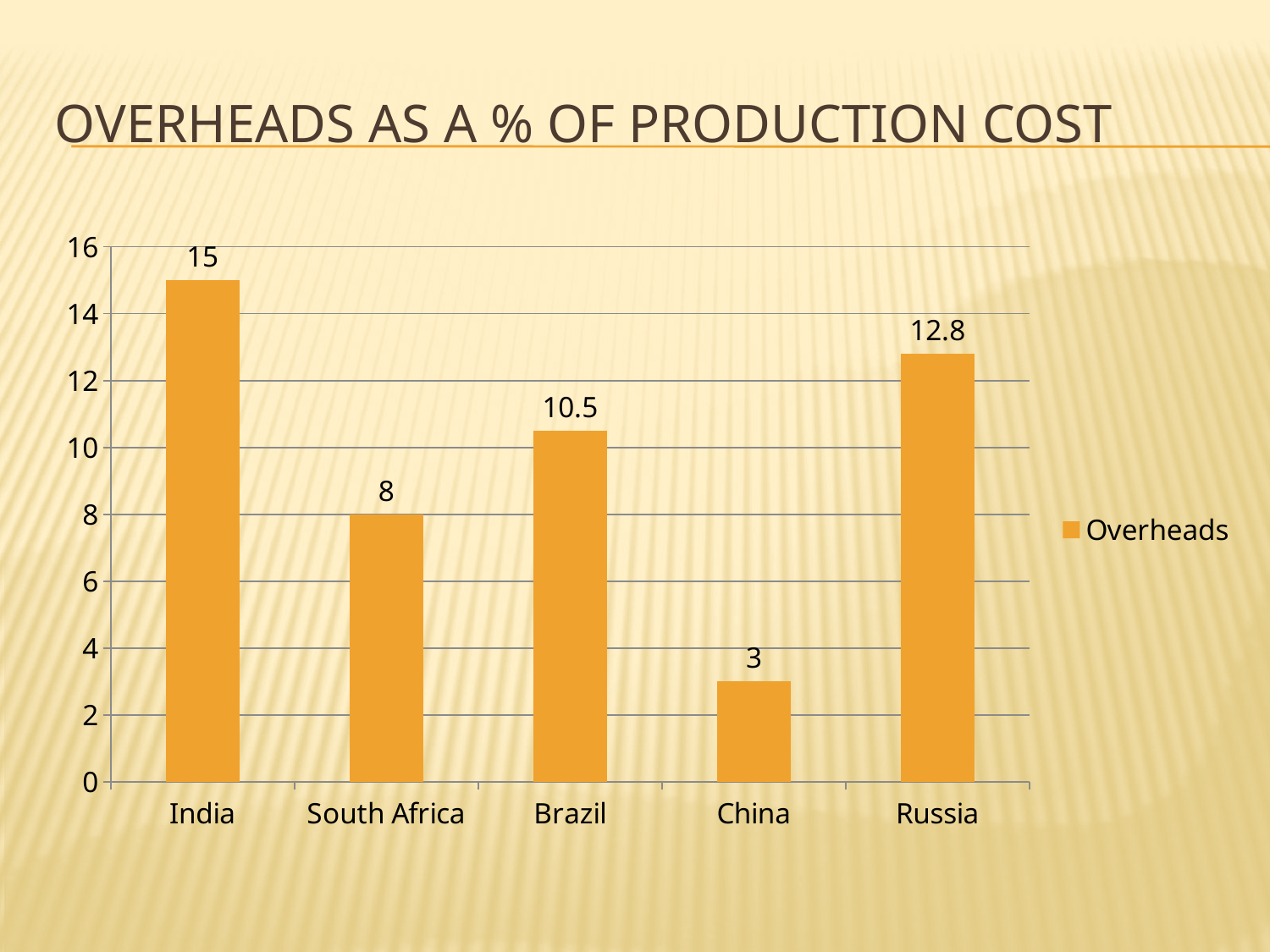
What is the value for China? 3 What series name does the legend show? Overheads What is the difference between the values for India and South Africa? 7 What is the value for Russia? 12.8 How many countries are shown on the chart? 5 What kind of chart is shown on the slide? bar chart Which country has the lowest value? China Which country has the highest value? India Is the value for Russia greater or less than 12? greater What is the difference between the values for Russia and Brazil? 2.3 What is the value for India? 15 Which is larger, the value for Brazil or the value for South Africa? Brazil